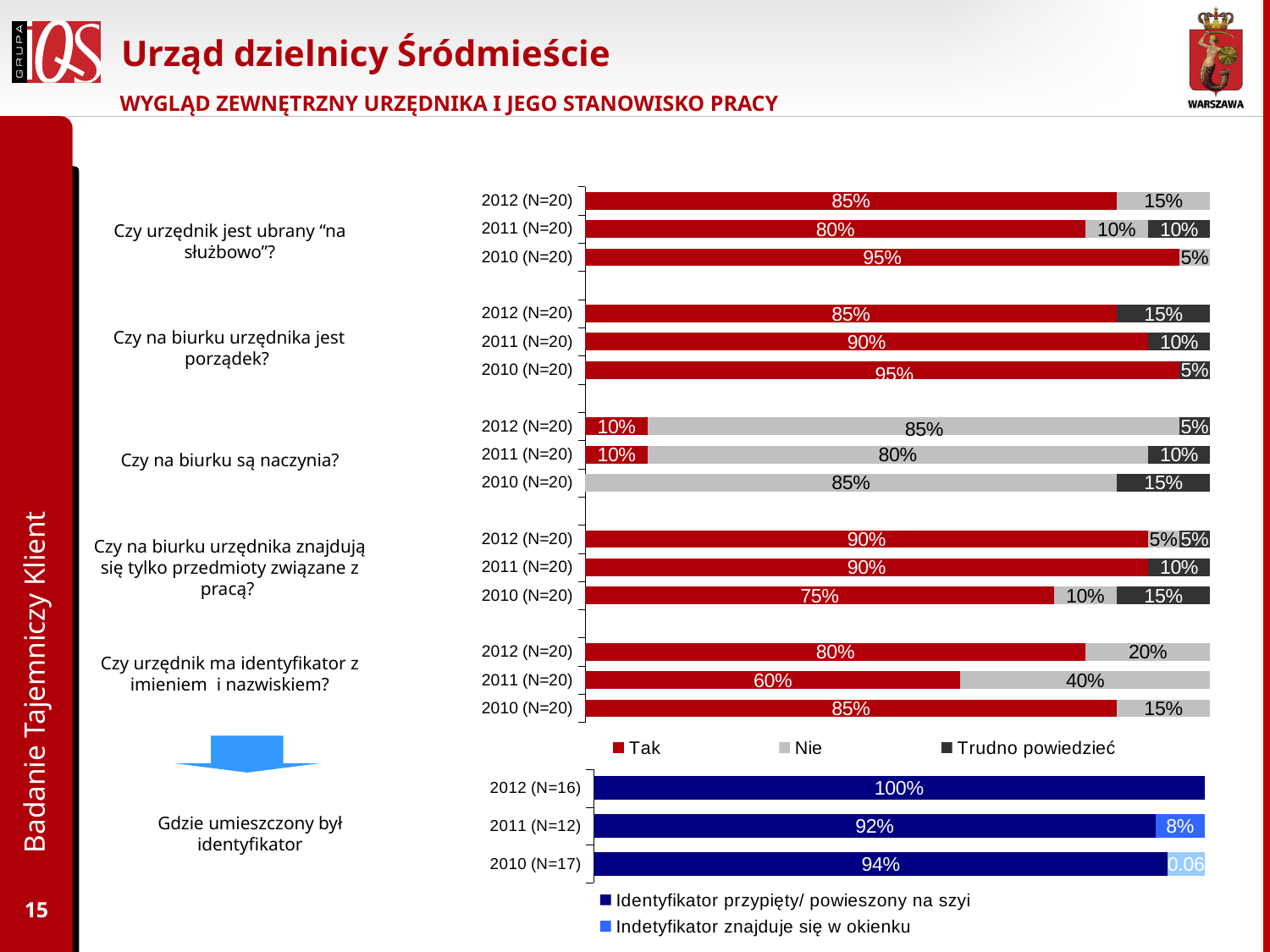
In the upper chart, what is the "Tak" value for "Czy na biurku urzędnika znajdują się tylko przedmioty związane z pracą?" in 2010 (N=20)? 75% In the lower chart ("Gdzie umieszczony był identyfikator"), what is the value for "Identyfikator przypięty/ powieszony na szyi" in 2012 (N=16)? 100% In the upper chart, what percentage answered "Tak" to "Czy urzędnik ma identyfikator z imieniem i nazwiskiem?" in 2011 (N=20)? 60% In the lower chart ("Gdzie umieszczony był identyfikator"), what is the value for "Identyfikator przypięty/ powieszony na szyi" in 2011 (N=12)? 92% In the upper chart, for "Czy urzędnik jest ubrany na służbowo?", which year has the highest "Tak" share? 2010 (N=20) How many series does the legend of the upper chart list? 3 In the upper chart, what is the difference between the "Tak" values for "Czy urzędnik ma identyfikator z imieniem i nazwiskiem?" in 2012 (N=20) and 2011 (N=20)? 20% What type of chart is the lower chart ("Gdzie umieszczony był identyfikator")? Stacked bar chart In the upper chart, what is the "Nie" value for "Czy na biurku są naczynia?" in 2012 (N=20)? 85% In the upper chart, for "Czy urzędnik ma identyfikator z imieniem i nazwiskiem?", which year has the lowest "Tak" share? 2011 (N=20) In the upper chart, what is the "Trudno powiedzieć" value for "Czy na biurku urzędnika jest porządek?" in 2012 (N=20)? 15% In the upper chart, is the "Tak" value for "Czy na biurku urzędnika jest porządek?" in 2011 (N=20) larger or smaller than the "Tak" value for the same question in 2012 (N=20)? larger